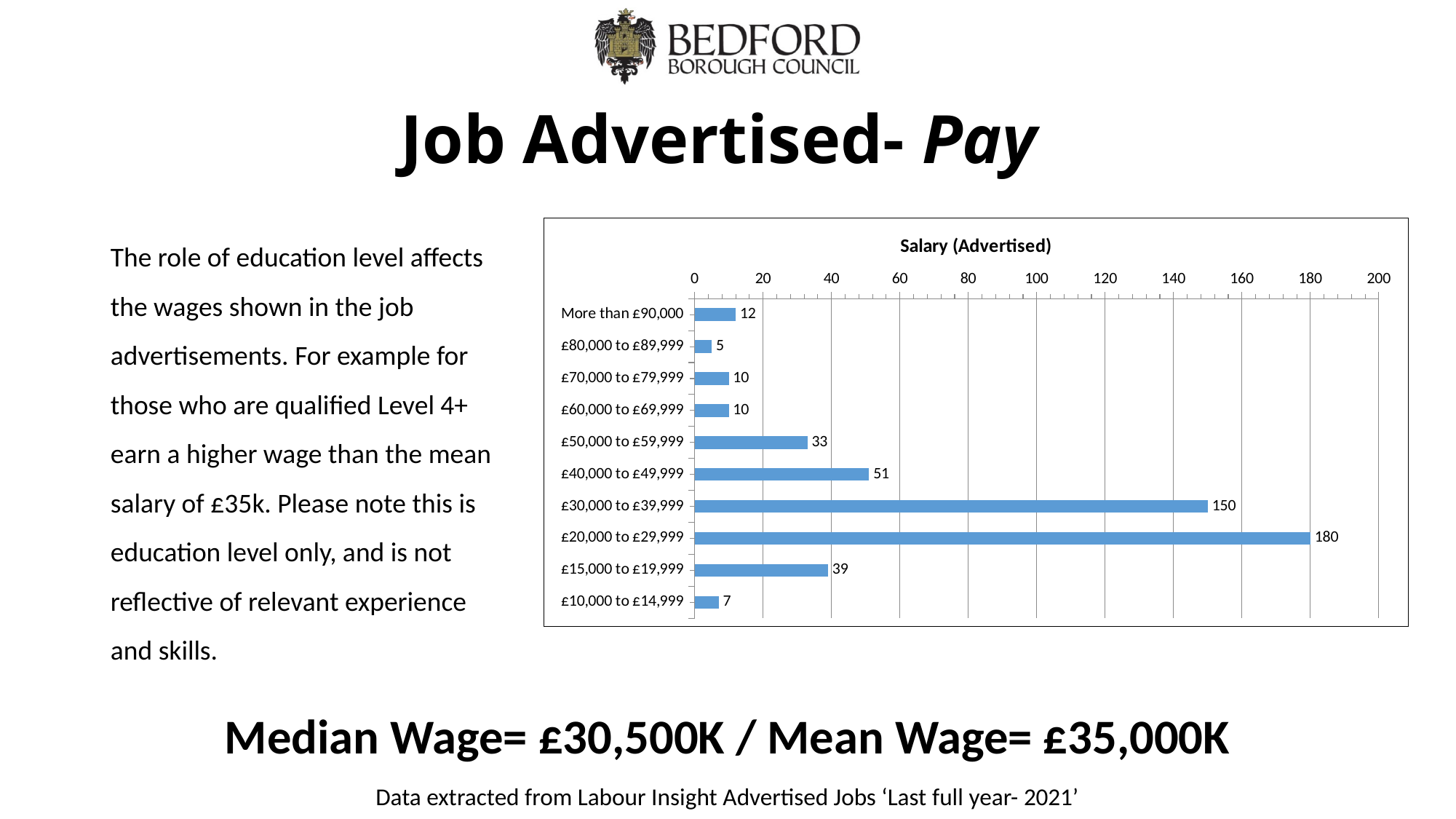
Which is larger, the value for £40,000 to £49,999 or the value for £15,000 to £19,999? £40,000 to £49,999 What is the value for the More than £90,000 salary band? 12 What is the difference between the values for £20,000 to £29,999 and £30,000 to £39,999? 30 Is the value for £30,000 to £39,999 greater or less than 140? greater How many salary bands are shown in the chart? 10 Which salary band has the lowest value? £80,000 to £89,999 What kind of chart is shown on the slide? bar chart What is the value for the £50,000 to £59,999 salary band? 33 Which salary band has the highest value? £20,000 to £29,999 What is the title of the chart? Salary (Advertised) What is the difference between the values for £15,000 to £19,999 and £10,000 to £14,999? 32 What is the value for the £20,000 to £29,999 salary band? 180